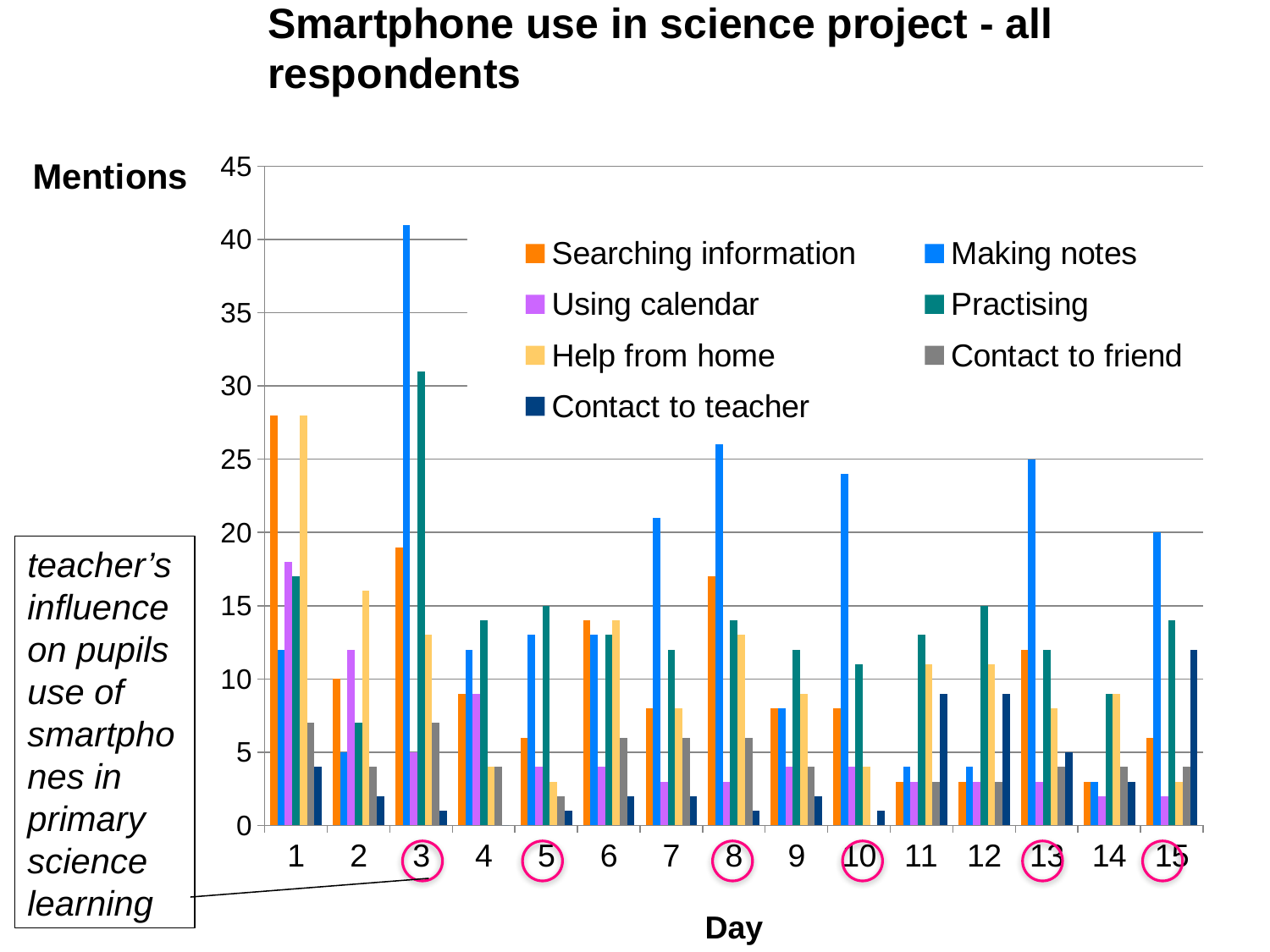
How many days are shown along the x axis? 15 Is the value for Making notes on day 3 greater or less than 40? greater How many series does the legend list? 7 On day 3, which series has the lowest bar? Contact to teacher On day 15, which is larger: Making notes or Contact to teacher? Making notes What kind of chart is shown on the slide? bar chart On day 1, which is larger: Searching information or Making notes? Searching information Is the value for Searching information on day 1 greater or less than 25? greater On which day is the Making notes bar highest? Day 3 Is the value for Practising on day 3 greater or less than 30? greater What is the title of the chart? Smartphone use in science project - all respondents